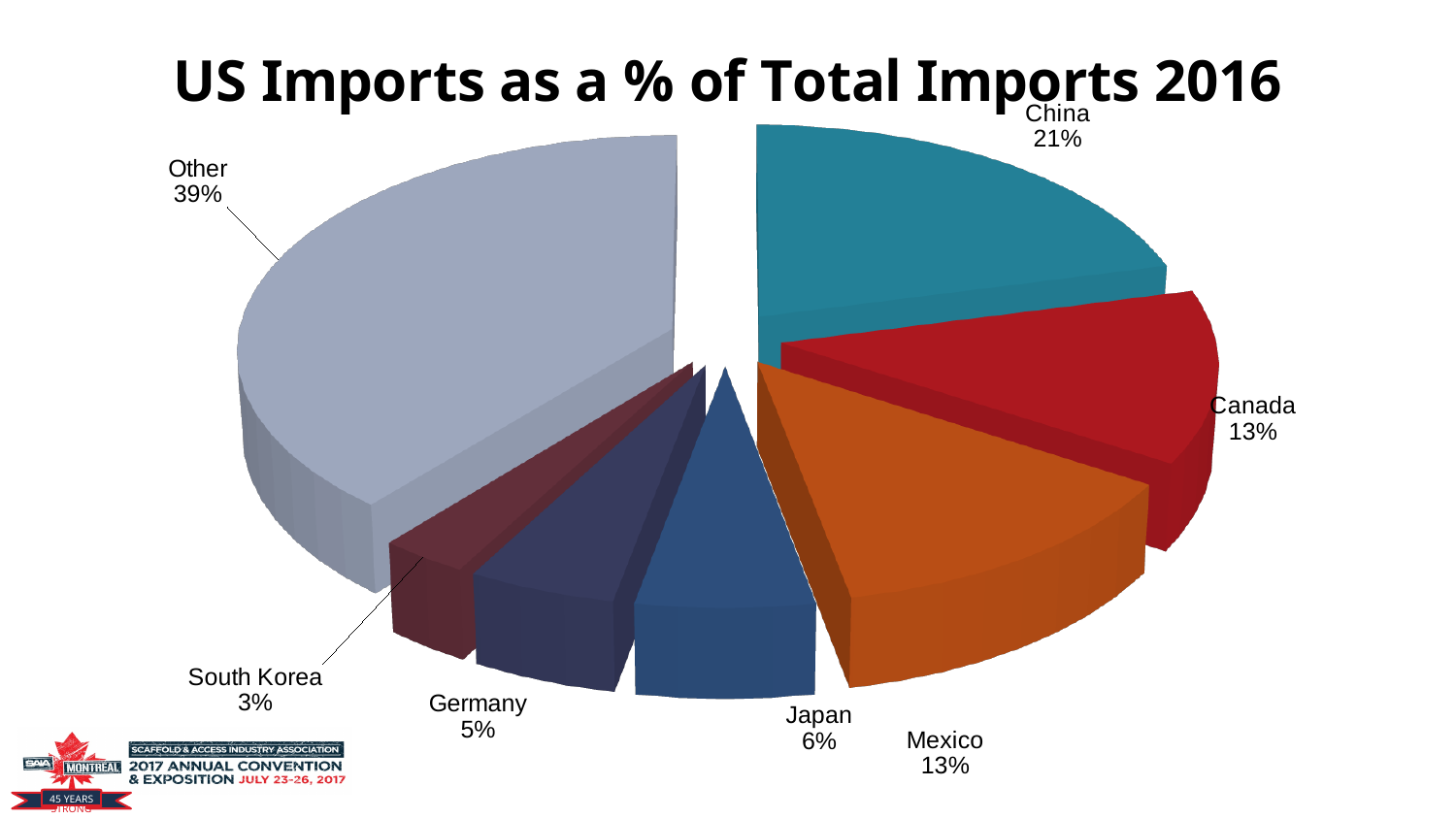
What is the combined share of Canada and Mexico? 26% What is the share shown for South Korea? 3% What share of US imports in 2016 came from China? 21% How many slices does the pie chart have? 7 What is the share shown for Germany? 5% What is the title of the chart? US Imports as a % of Total Imports 2016 Which category has the largest slice of the pie? Other What type of chart is shown on the slide? Pie chart Which named country has the smallest share of US imports? South Korea Which has a larger share of US imports, Germany or Japan? Japan What percentage of total imports is attributed to Mexico? 13% How many percentage points larger is China's share than Japan's? 15